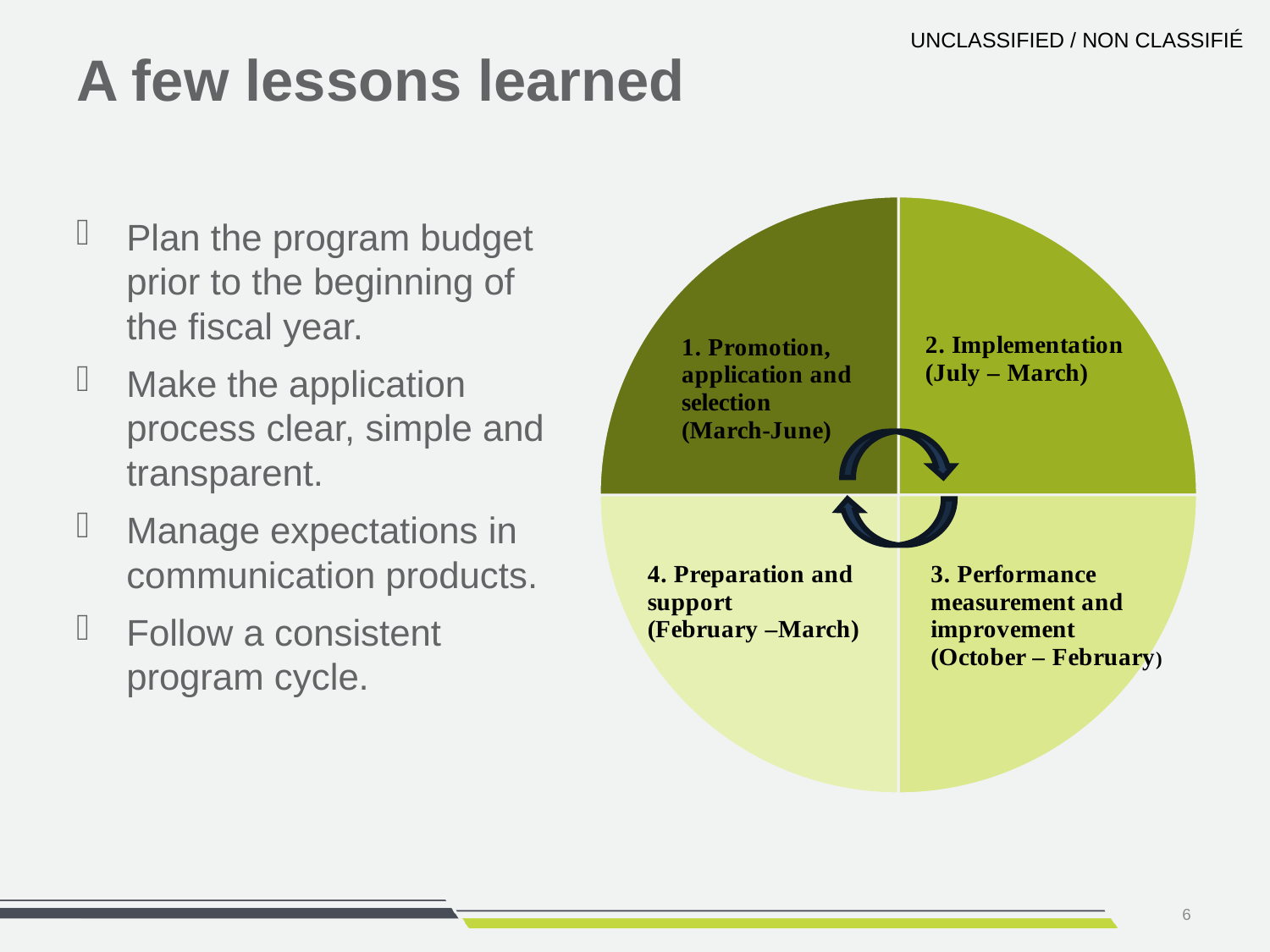
Which months are shown for the segment "3. Performance measurement and improvement"? October – February Which segment of the pie chart is numbered 4? Preparation and support What kind of chart is shown on the slide? pie chart Which segment of the pie chart is labelled with the period July – March? 2. Implementation How many segments does the pie chart have? 4 Which months are shown for the segment "4. Preparation and support"? February –March Which segment of the pie chart is labelled with the period October – February? 3. Performance measurement and improvement Which segment of the pie chart is the darkest green? 1. Promotion, application and selection Which months are shown for the segment "1. Promotion, application and selection"? March-June Which months are shown for the segment "2. Implementation"? July – March